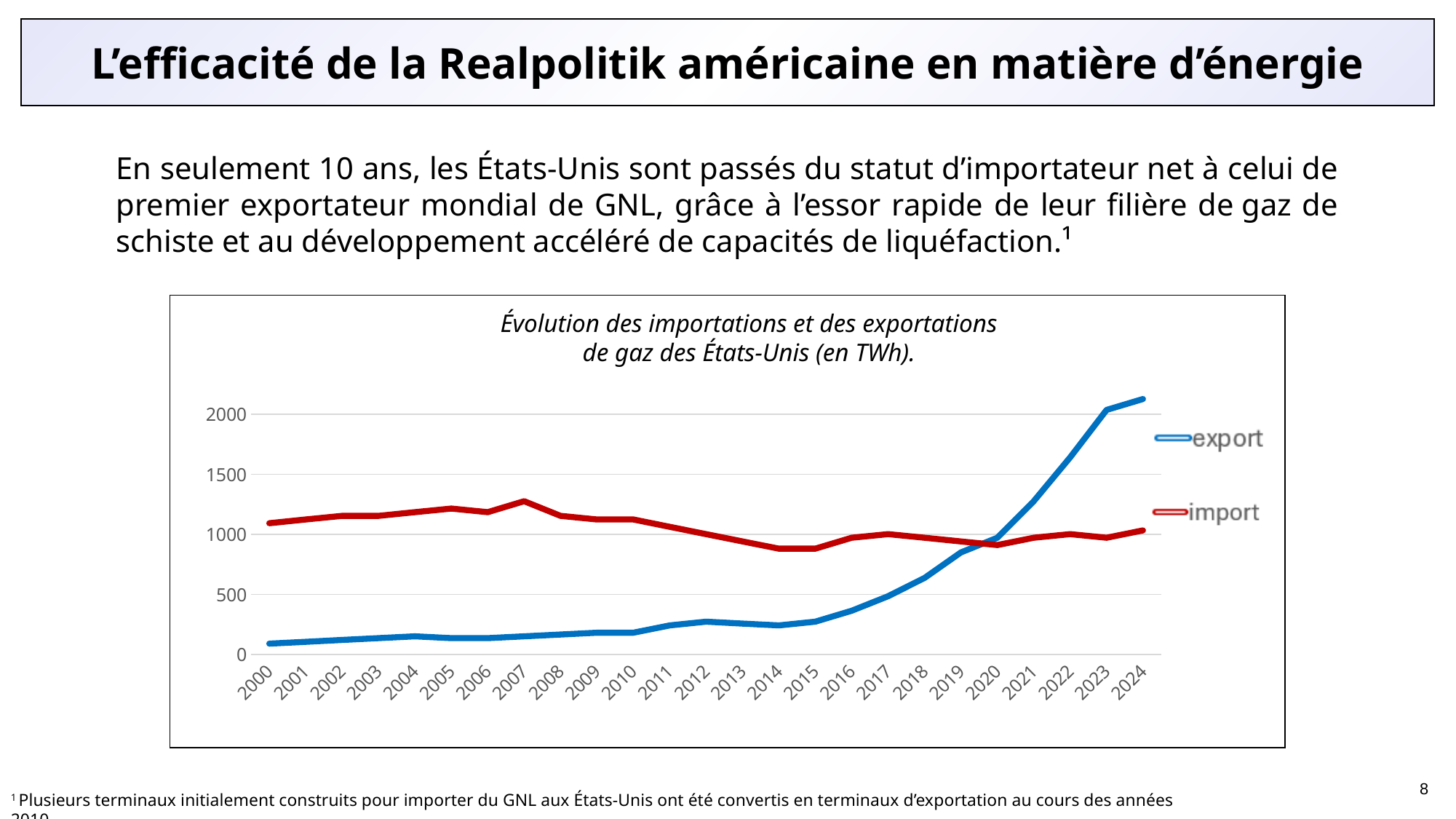
Is the export value for 2024 greater or less than 2000? greater How many years are plotted along the x axis? 25 Does the export series rise or fall from 2000 to 2024? rise How many series does the legend list? 2 In 2010, which is larger, export or import? import Is the import value for 2007 greater or less than 1000? greater Is the export value for 2000 greater or less than 500? less In 2024, which is larger, export or import? export In which year does the export series reach its highest value? 2024 What kind of chart is shown on the slide? line chart